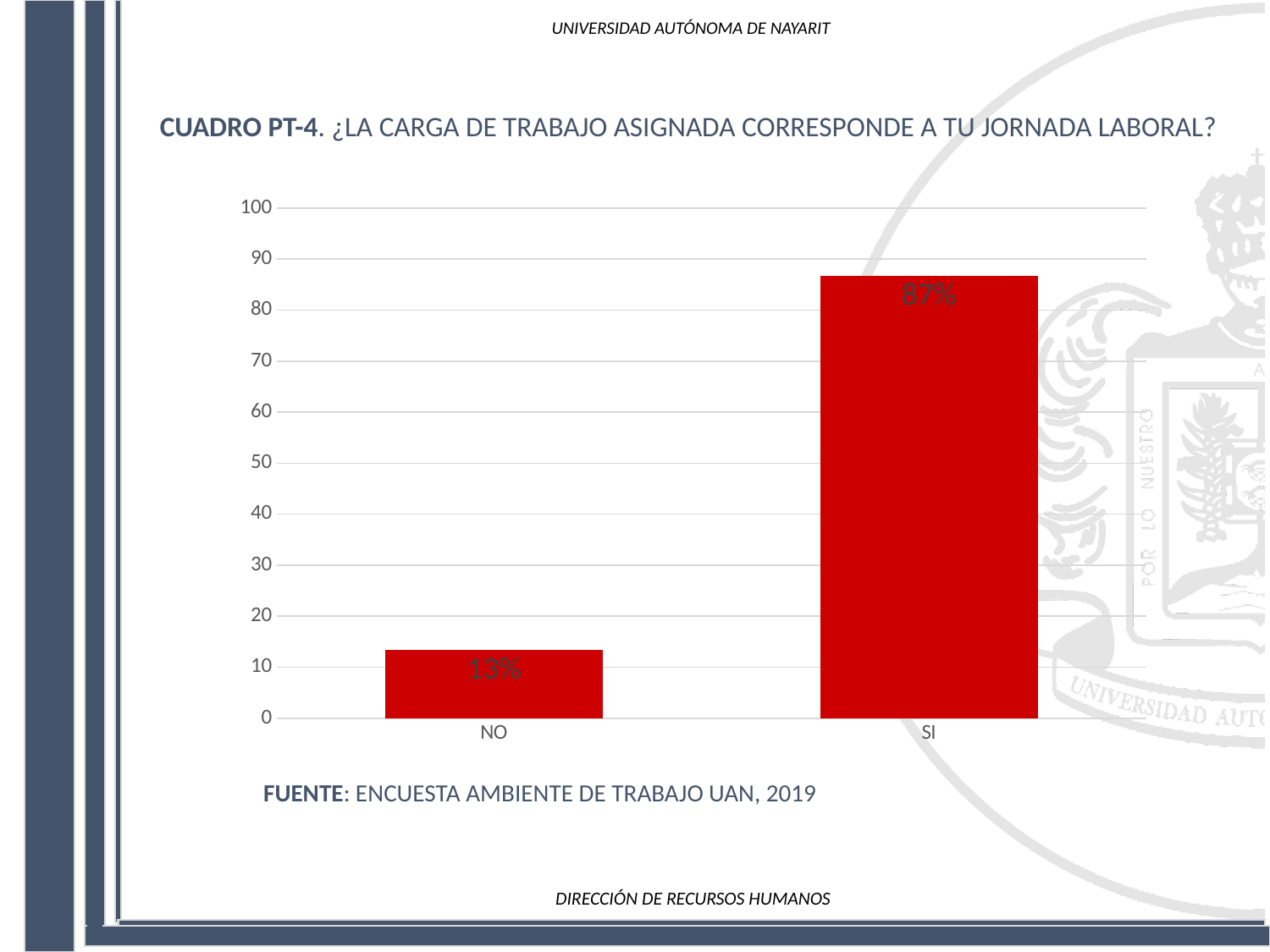
What kind of chart is shown on the slide? bar chart What is the value for SI? 87% What is the difference between the values for SI and NO? 74% What is the source cited below the chart? ENCUESTA AMBIENTE DE TRABAJO UAN, 2019 Is the value for SI greater or less than 80? greater Is the value for NO greater or less than 20? less Which is larger, the value for NO or the value for SI? SI How many categories are shown on the x axis? 2 Which category has the lowest value? NO What is the value for NO? 13% Which category has the highest value? SI What colour are the bars in the chart? red